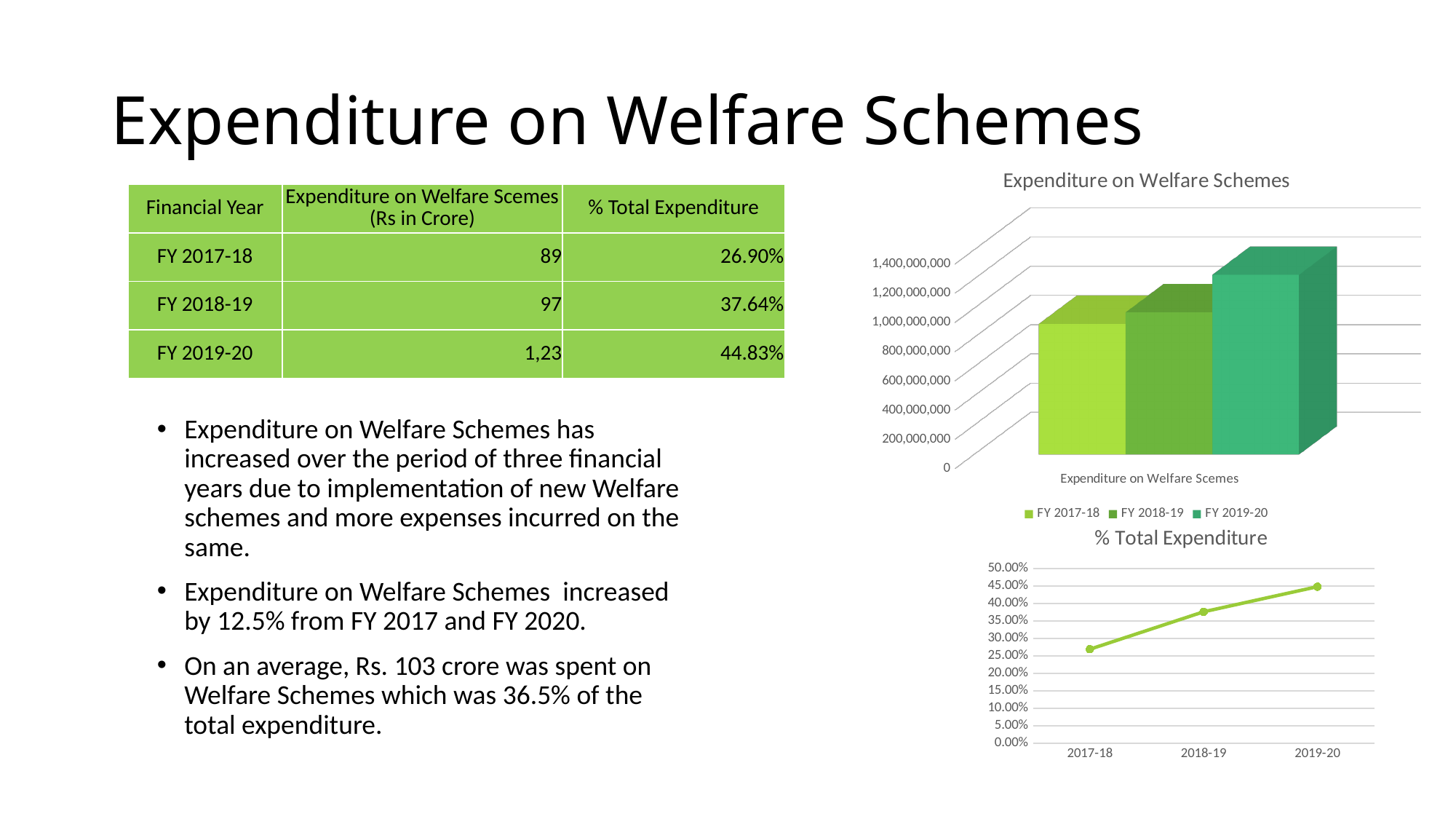
In the "% Total Expenditure" line chart, how many points are plotted? 3 In the "% Total Expenditure" line chart, do the values rise or fall from 2017-18 to 2019-20? rise What kind of chart is the "% Total Expenditure" chart at the bottom right? line chart What kind of chart is the "Expenditure on Welfare Schemes" chart at the top right? bar chart In the "Expenditure on Welfare Schemes" bar chart, is the value for FY 2019-20 greater or less than 1,000,000,000? greater In the "Expenditure on Welfare Schemes" bar chart, which financial year has the tallest bar? FY 2019-20 In the "% Total Expenditure" line chart, which year has the lowest value? 2017-18 In the "% Total Expenditure" line chart, is the value for 2019-20 greater or less than 40.00%? greater In the "Expenditure on Welfare Schemes" bar chart, which is larger: the bar for FY 2018-19 or the bar for FY 2017-18? FY 2018-19 In the "% Total Expenditure" line chart, which year has the highest value? 2019-20 In the "Expenditure on Welfare Schemes" bar chart, which financial year has the shortest bar? FY 2017-18 In the "Expenditure on Welfare Schemes" bar chart, how many series does the legend list? 3